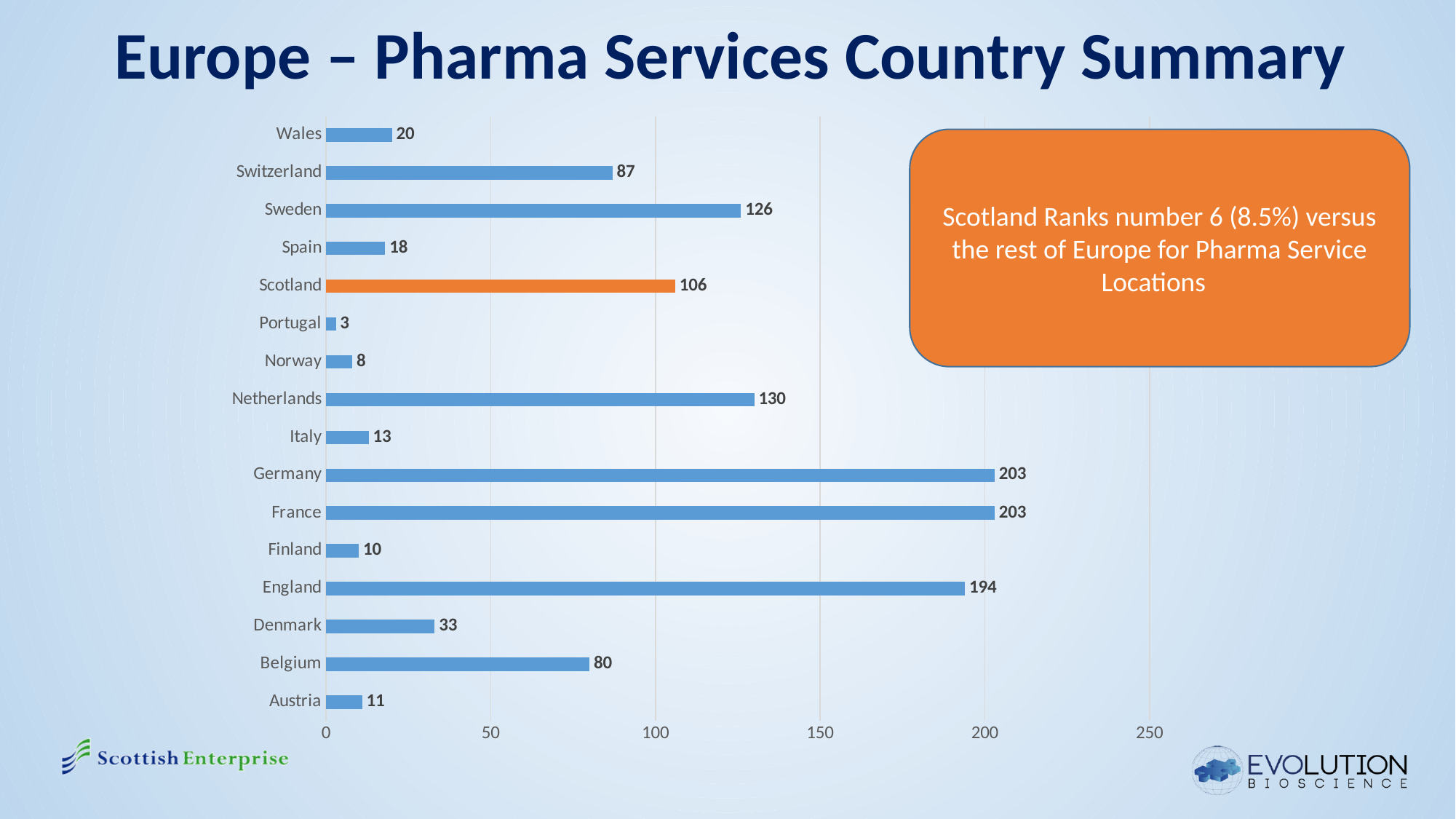
What is the difference between the values for Germany and England? 9 What is the value for Netherlands? 130 Which country has the lowest value? Portugal How many countries are shown on the chart? 16 What is the value for England? 194 Which has a larger value, Denmark or Wales? Denmark What is the value for Scotland? 106 What kind of chart is shown on the slide? Bar chart What is the difference between the values for Netherlands and Sweden? 4 Which has a larger value, Switzerland or Belgium? Switzerland Which country's bar is coloured orange instead of blue? Scotland What is the value for Portugal? 3